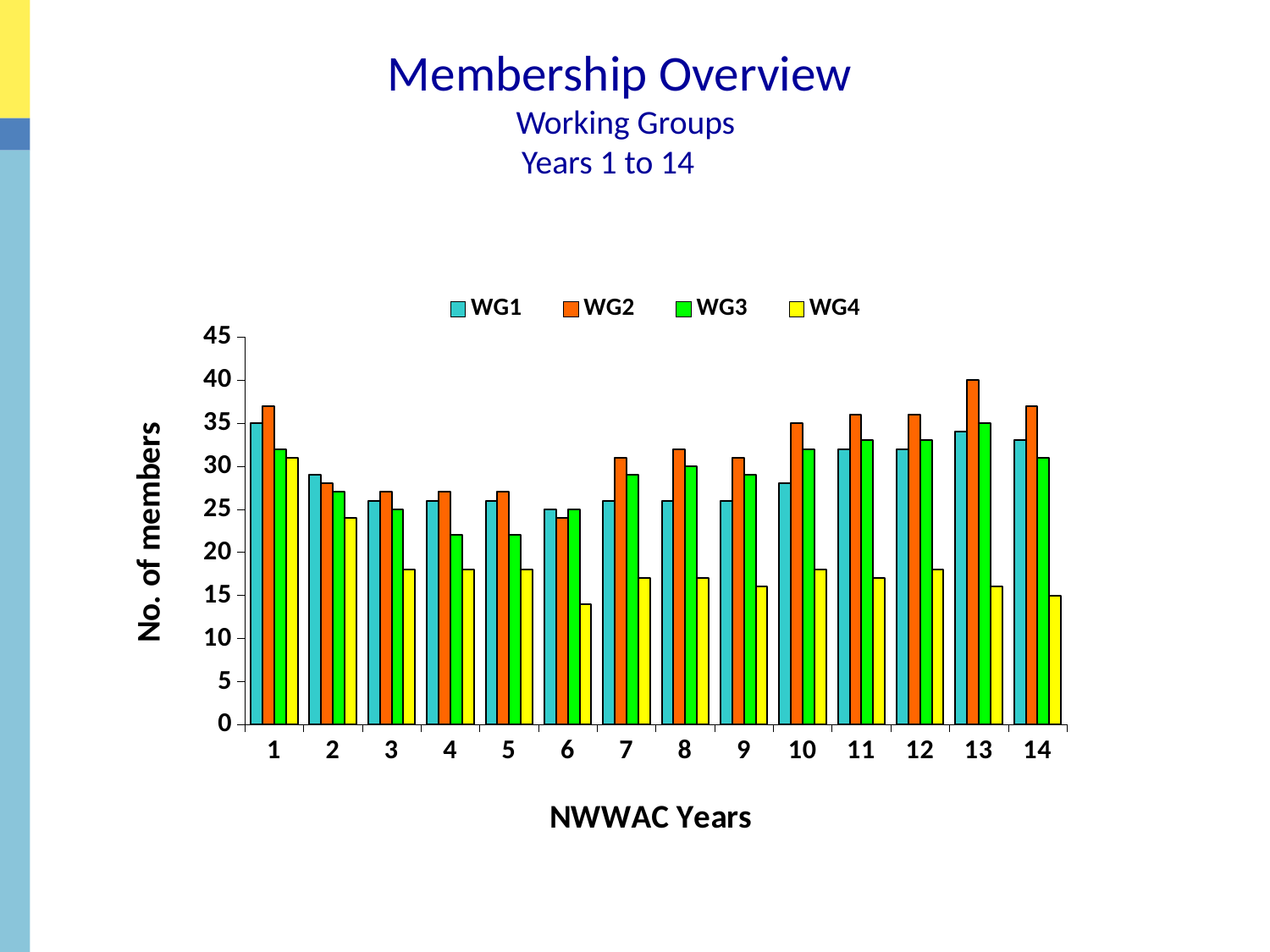
In year 13, which has more members, WG2 or WG4? WG2 Is the value for WG1 in year 10 greater or less than 30? less What kind of chart is shown on the slide? bar chart In which year does WG2 reach its highest number of members? 13 Is the value for WG4 in year 3 greater or less than 20? less What is the number of members for WG1 in year 1? 35 Does the WG2 series rise or fall from year 6 to year 13? rise How many series does the legend list? 4 Is the value for WG3 in year 4 greater or less than 25? less What is the number of members for WG2 in year 13? 40 What is the title of the y axis? No. of members How many years are shown along the x axis? 14